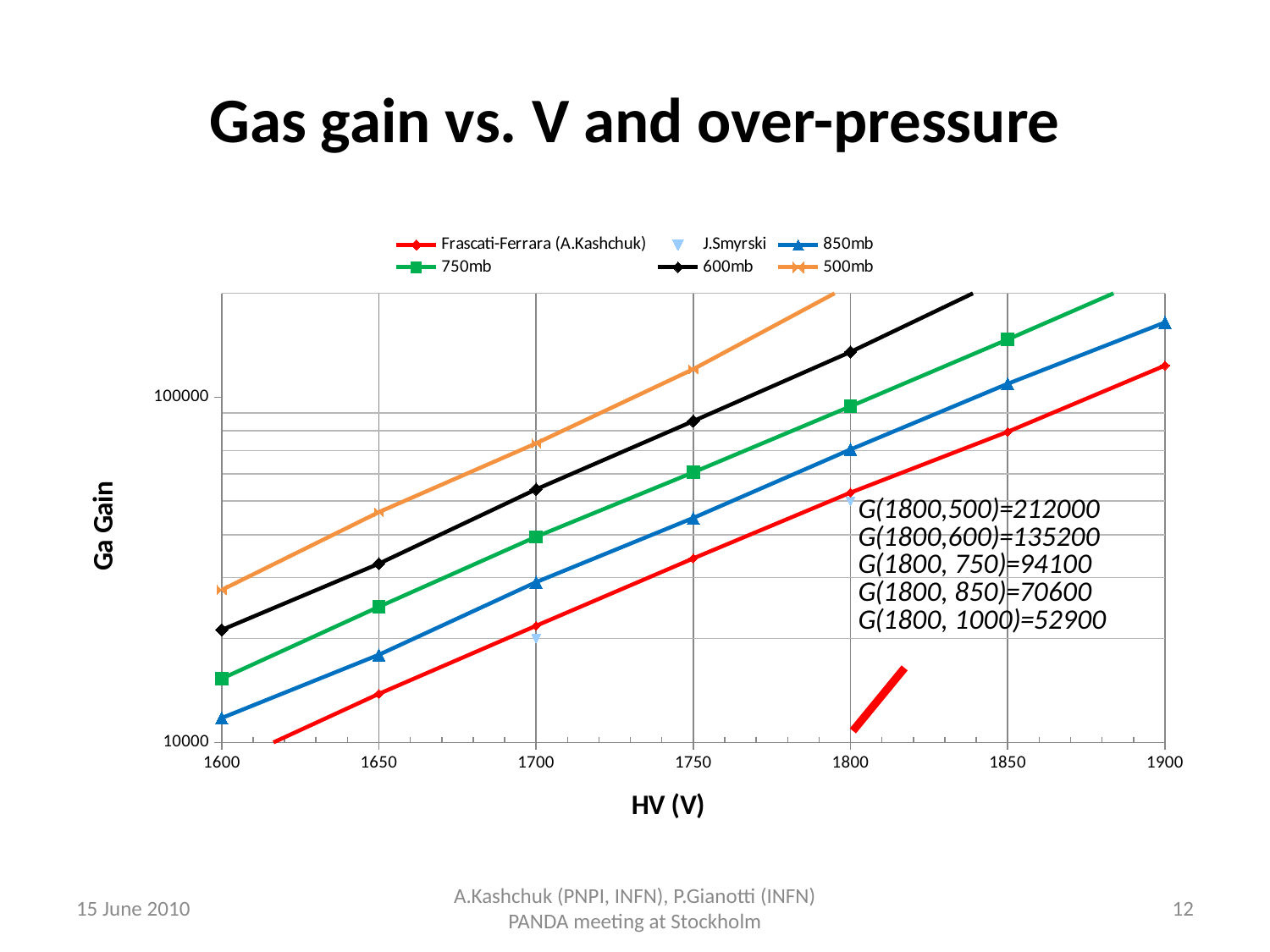
According to the annotation on the chart, what is G(1800, 850)? 70600 Does the gas gain rise or fall as HV increases along the x axis? rise According to the annotation on the chart, what is G(1800, 1000)? 52900 At 1700 V, which series has the larger gas gain, 600mb or 850mb? 600mb Using the annotated values, what is the difference between G(1800, 750) and G(1800, 850)? 23500 Is the value of the 600mb series at 1800 V greater or less than 100000? greater What kind of chart is shown on the slide? line chart What is the title of the chart on the slide? Gas gain vs. V and over-pressure According to the annotation on the chart, what is G(1800,500)? 212000 Using the annotated values, what is the difference between G(1800,500) and G(1800,600)? 76800 What is the label of the x axis of the chart? HV (V) How many series does the chart legend list? 6